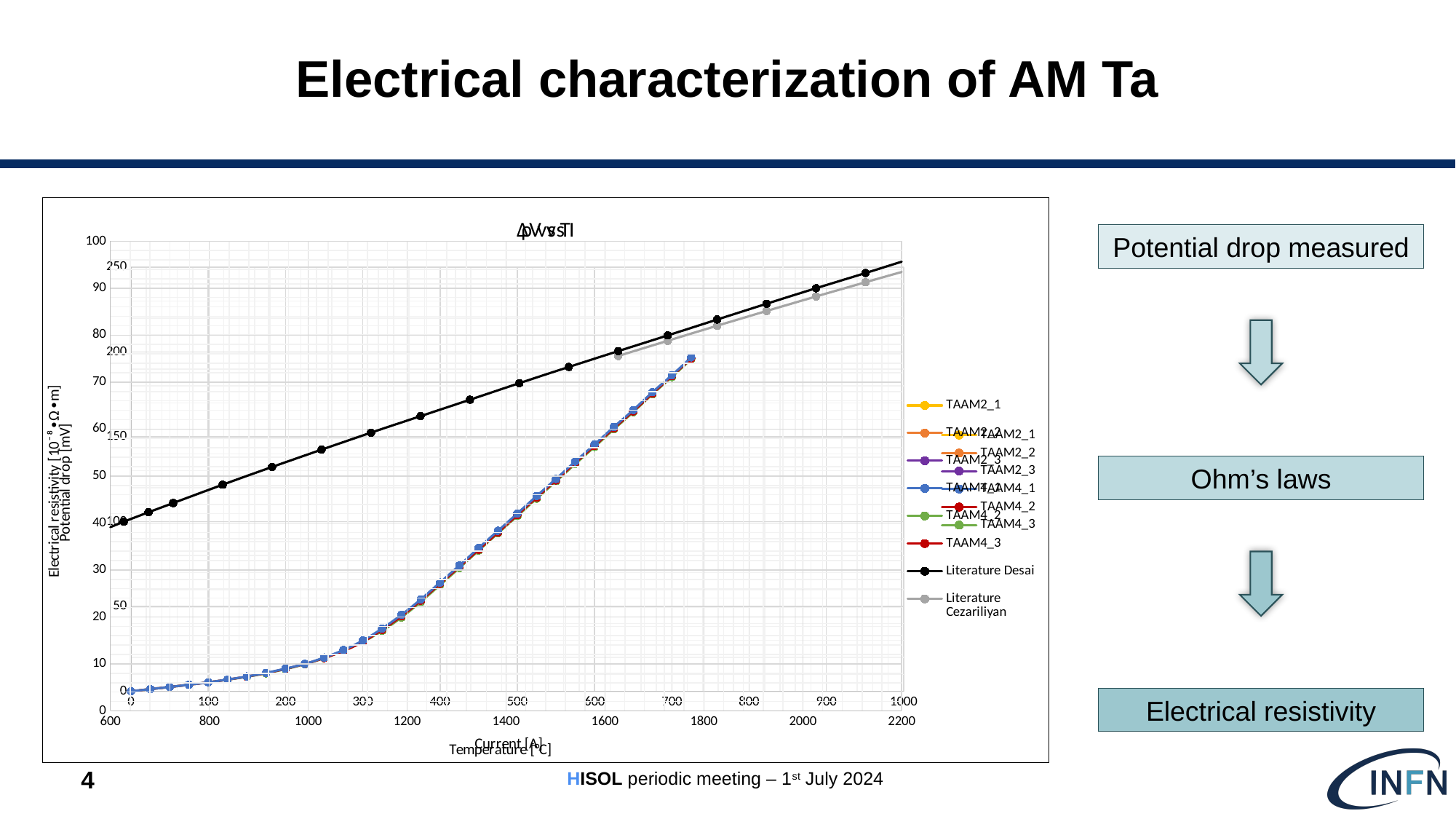
In the ρ vs T chart, does the Literature Desai series rise or fall as temperature increases? rises In the ΔV vs I chart, is the potential drop at 700 A greater or less than 150 mV? greater In the ΔV vs I chart, is the potential drop at 300 A greater or less than 50 mV? less What kind of chart is the ρ vs T chart on the slide? line chart In the ρ vs T chart, which literature series is higher at the right end of the temperature axis, Literature Desai or Literature Cezariliyan? Literature Desai How many series does the legend of the ρ vs T chart list? 8 In the ΔV vs I chart, do the TAAM potential drop curves rise or fall as current increases? rise What colour is the Literature Desai series in the ρ vs T chart? black What is the x-axis label of the ρ vs T chart? Temperature [°C] In the ρ vs T chart, is the Literature Desai value at 2000 °C greater or less than 80? greater How many TAAM sample series are listed in the legend of the ΔV vs I chart? 6